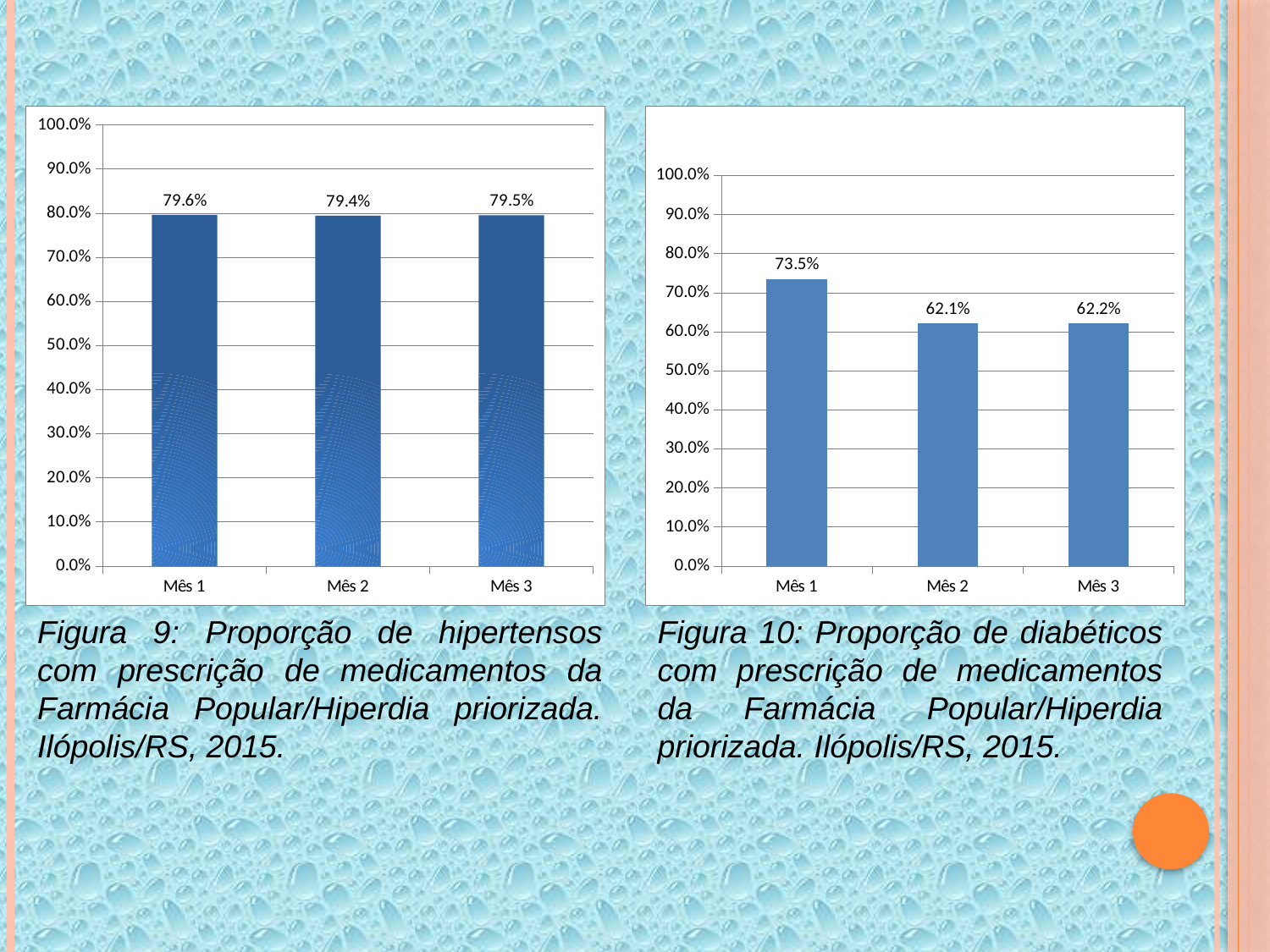
In the left chart (Figura 9), what is the value for Mês 2? 79.4% How many months are shown on the x axis of the right chart (Figura 10)? 3 In the left chart (Figura 9), is the value for Mês 3 greater or less than 70.0%? greater In the left chart (Figura 9), what is the difference between the values for Mês 1 and Mês 2? 0.2% In the right chart (Figura 10), what is the value for Mês 3? 62.2% In the right chart (Figura 10), what is the value for Mês 1? 73.5% What kind of chart is the left chart (Figura 9)? bar chart In the left chart (Figura 9), what is the value for Mês 1? 79.6% In the right chart (Figura 10), which month has the highest value? Mês 1 In the right chart (Figura 10), what is the difference between the values for Mês 1 and Mês 2? 11.4% In the right chart (Figura 10), is the value for Mês 1 larger or smaller than the value for Mês 3? larger In the right chart (Figura 10), does the value rise or fall from Mês 1 to Mês 2? fall